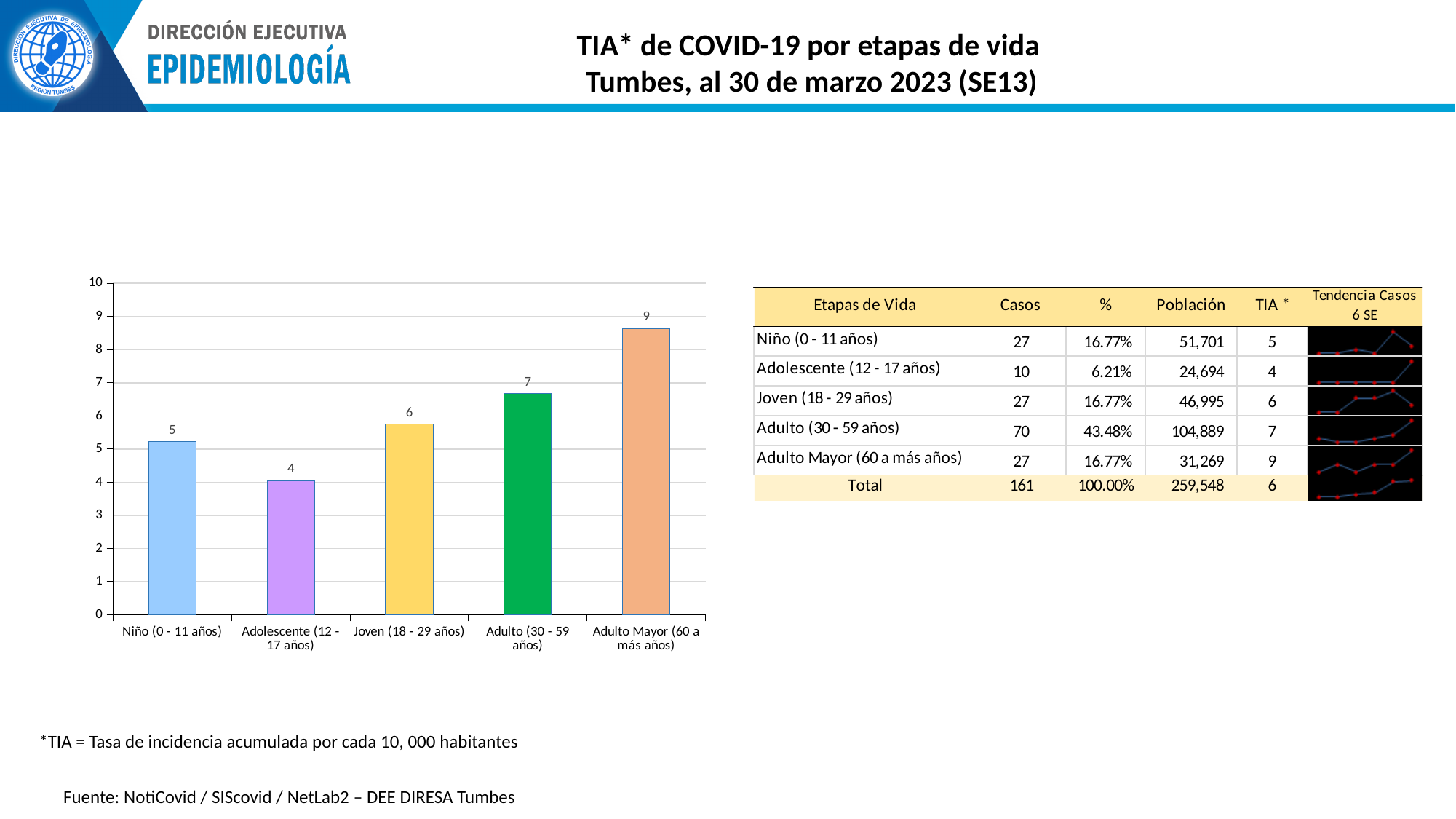
What is the maximum value shown on the vertical axis of the bar chart? 10 What is the data label shown for Adolescente (12 - 17 años) in the bar chart? 4 How many age-group categories are plotted in the bar chart? 5 What kind of chart is shown on the slide? bar chart Which category has the lowest bar in the chart? Adolescente (12 - 17 años) What is the data label shown for Adulto (30 - 59 años) in the bar chart? 7 Which bar is taller: Joven (18 - 29 años) or Adulto (30 - 59 años)? Adulto (30 - 59 años) What is the data label shown for Niño (0 - 11 años) in the bar chart? 5 Is the value for Adulto Mayor (60 a más años) greater or less than 8? greater What is the data label shown for Joven (18 - 29 años) in the bar chart? 6 Which category has the highest bar in the chart? Adulto Mayor (60 a más años) What is the data label shown for Adulto Mayor (60 a más años) in the bar chart? 9